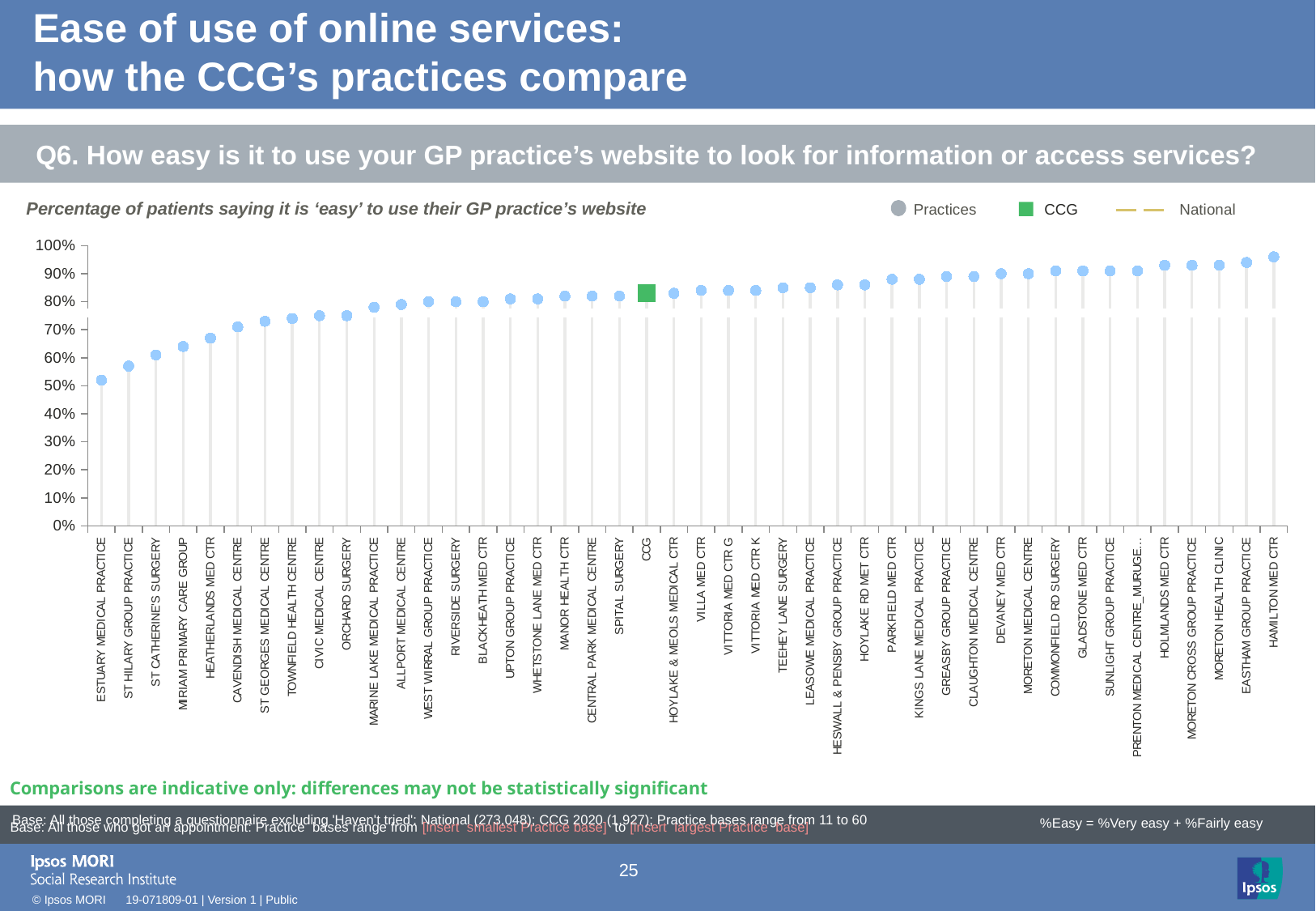
Is the value for MARINE LAKE MEDICAL PRACTICE greater or less than 80%? less Which practice has the highest percentage of patients saying it is 'easy' to use their GP practice's website? HAMILTON MED CTR What colour is the marker used for the CCG in the chart? green Is the value for ESTUARY MEDICAL PRACTICE greater or less than 50%? greater Do the values rise or fall moving from left to right along the x axis? rise Which practice has the lowest percentage of patients saying it is 'easy' to use their GP practice's website? ESTUARY MEDICAL PRACTICE Is the value for CCG greater or less than 80%? greater Which has a higher value, ST HILARY GROUP PRACTICE or EASTHAM GROUP PRACTICE? EASTHAM GROUP PRACTICE How many entries does the legend list? 3